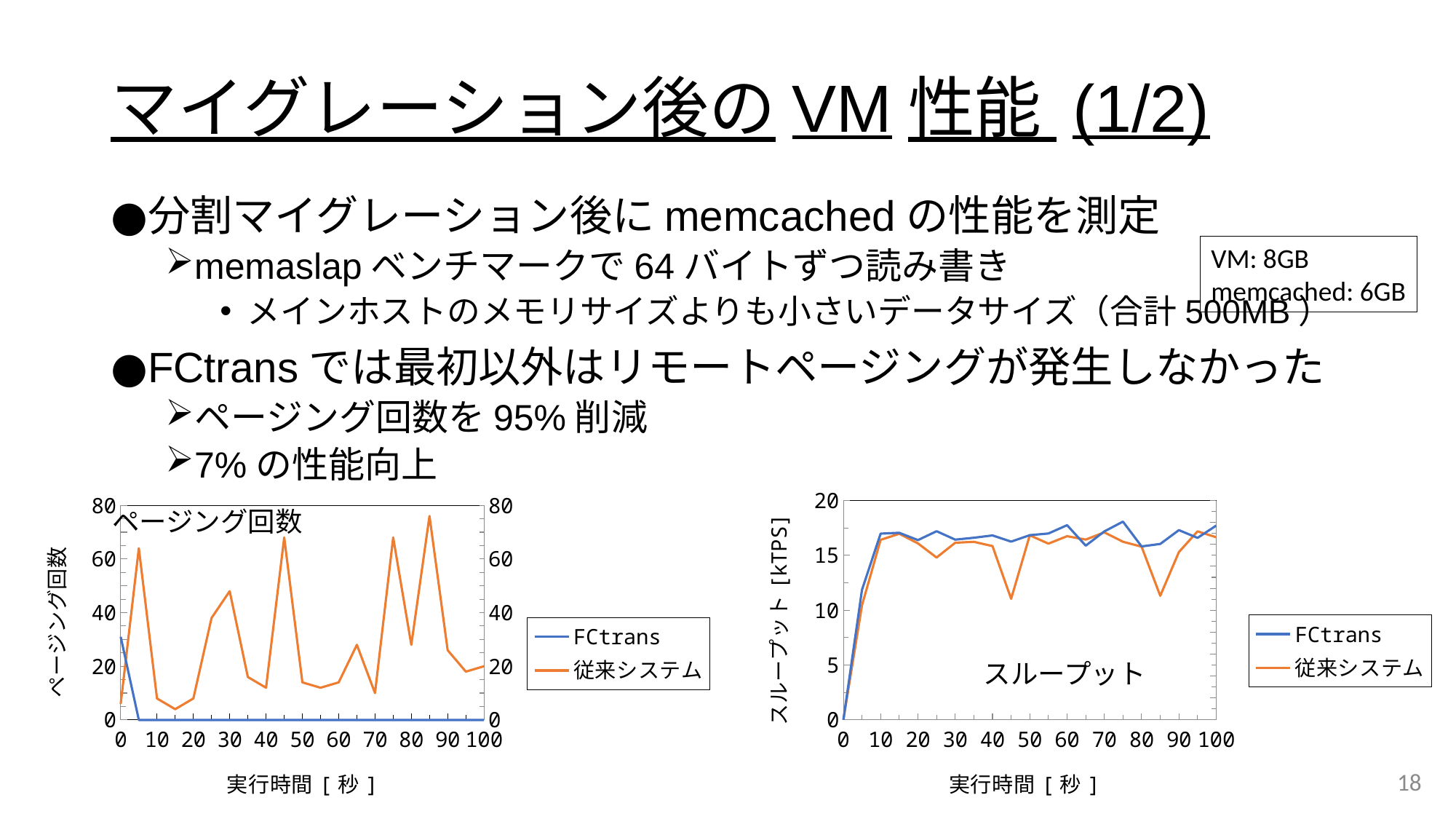
In the right chart (スループット), is the value for 従来システム at 45 seconds greater or less than 15? less How many series does the legend of the right chart (スループット) list? 2 In the left chart (ページング回数), is the value for 従来システム at 15 seconds greater or less than 20? less What kind of chart is the left chart titled ページング回数? line chart In the left chart (ページング回数), is the value for 従来システム at 85 seconds greater or less than 60? greater In the right chart, does the FCtrans line rise or fall between 0 and 10 seconds? rise In the right chart (スループット), which series has the higher value at 45 seconds, FCtrans or 従来システム? FCtrans In the left chart (ページング回数), what is the value for FCtrans at 50 seconds? 0 In the right chart (スループット), what is the value for 従来システム at 0 seconds? 0 In the left chart (ページング回数), which series has the higher value at 85 seconds, FCtrans or 従来システム? 従来システム What is the y-axis label of the right chart? スループット [kTPS]